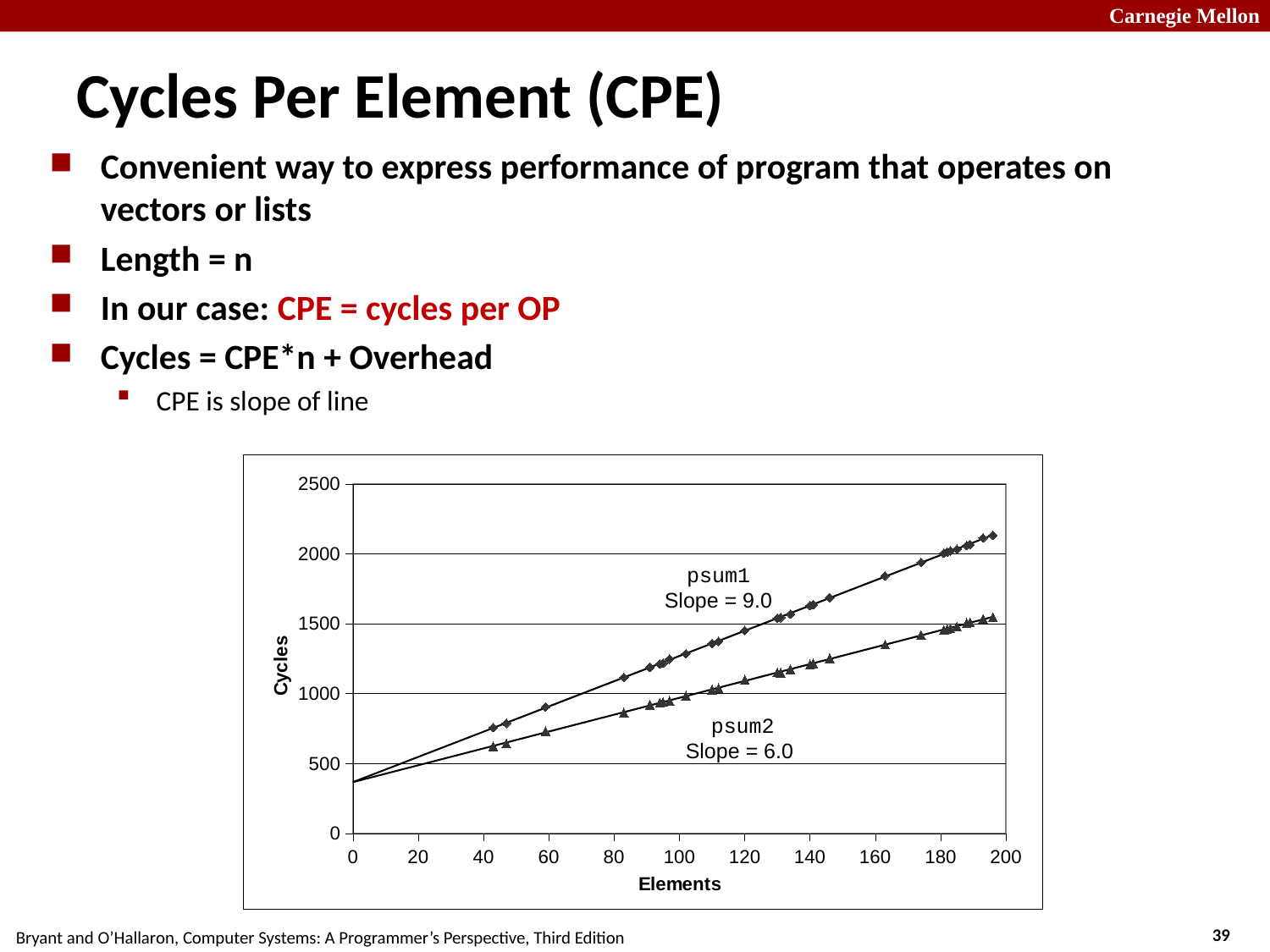
How many data series are plotted on the chart? 2 What is the difference between the slopes of psum1 and psum2? 3.0 What is the slope of the psum2 line? 6.0 Do the cycle counts rise or fall as the number of elements increases? rise Is the value for psum1 at about 195 elements greater or less than 2000 cycles? greater What is the label of the y axis? Cycles Which series has the larger slope, psum1 or psum2? psum1 Is the value for psum2 at about 195 elements greater or less than 2000 cycles? less What is the label of the x axis? Elements What kind of chart is shown on the slide? scatter chart with fitted lines What is the slope of the psum1 line? 9.0 Is the value for psum2 at about 60 elements greater or less than 1000 cycles? less